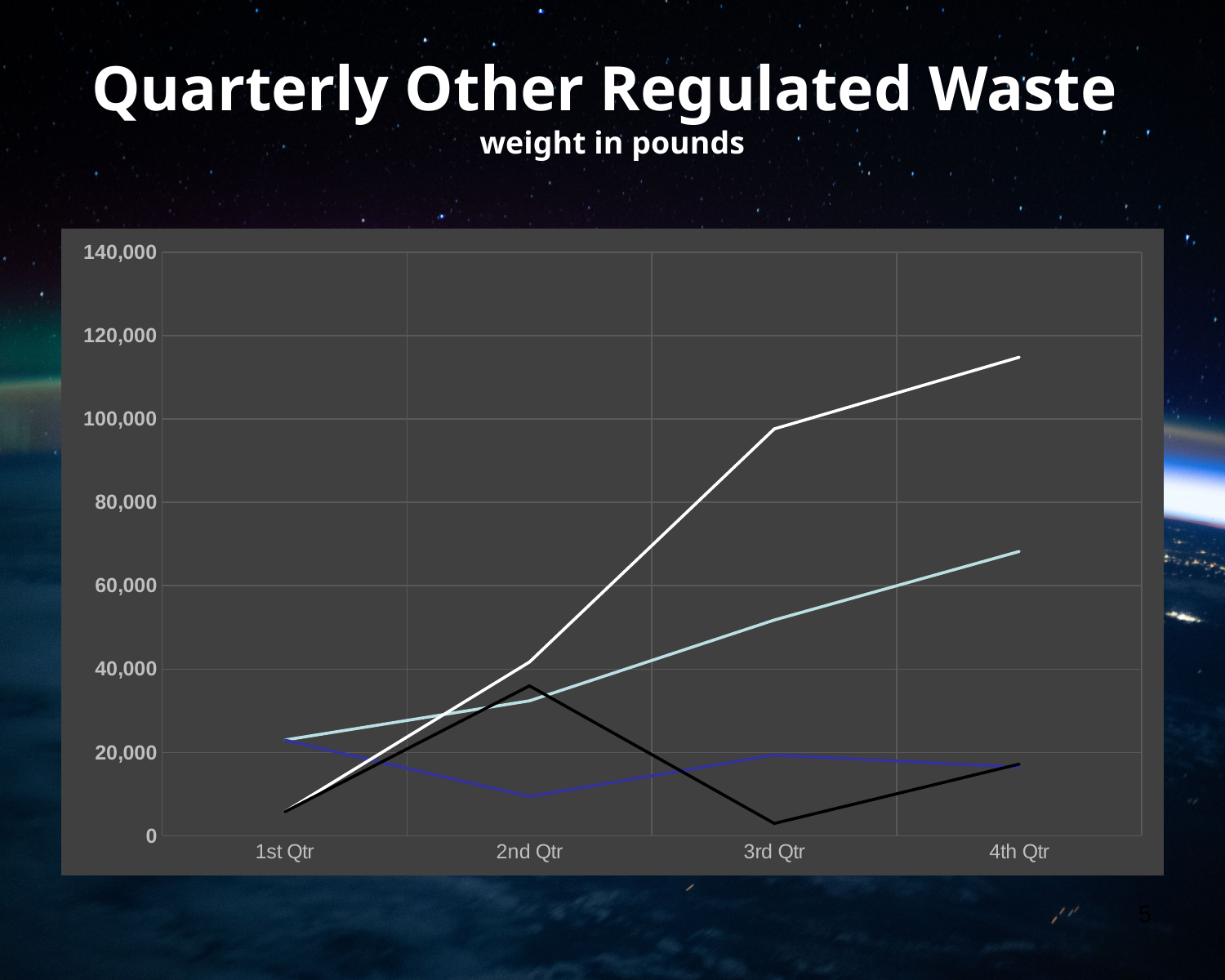
How many lines are plotted on the chart? 4 What is the title of the chart on the slide? Quarterly Other Regulated Waste Is the value of the light blue line in 4th Qtr greater or less than 60,000? greater In which quarter does the black line reach its lowest value? 3rd Qtr What unit does the subtitle say the chart's values are in? weight in pounds Does the white line rise or fall from 1st Qtr to 4th Qtr? rise Is the value of the white line in 4th Qtr greater or less than 100,000? greater Is the value of the dark blue line in 2nd Qtr greater or less than 20,000? less In which quarter does the black line reach its highest value? 2nd Qtr How many quarters are shown on the x axis of the chart? 4 What kind of chart is shown on the slide? line chart